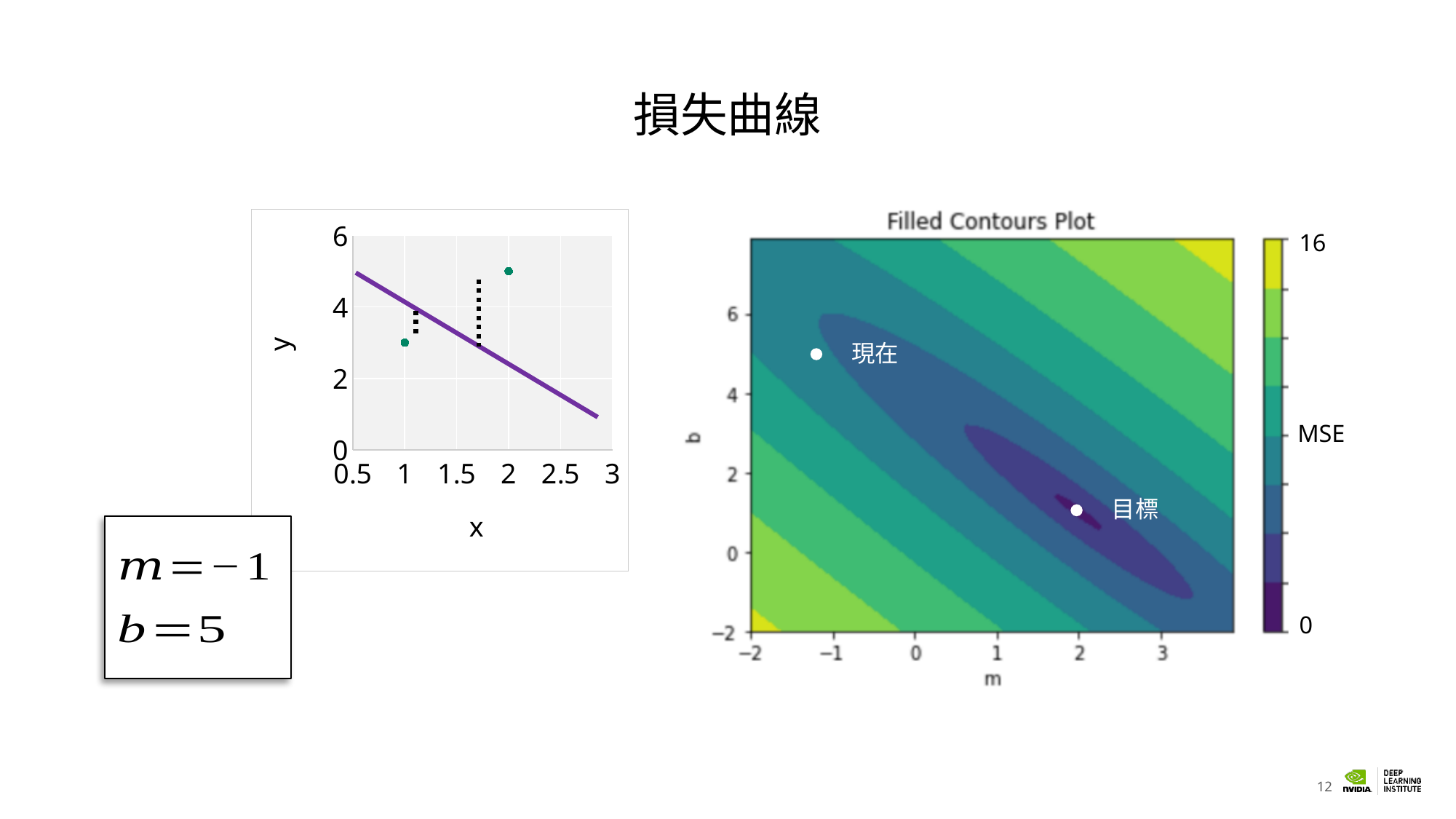
In the right chart, is the b value of the point labelled 現在 greater or less than 4? greater What is the title of the right chart? Filled Contours Plot In the right chart, what is the maximum value shown on the MSE colour bar? 16 In the left chart, which data point has the higher y value, the one at x = 1 or the one at x = 2? The one at x = 2 In the left chart, how many green data points are plotted? 2 In the right chart, is the m value of the point labelled 現在 greater or less than 0? less In the right chart, which labelled point has the larger b value, 現在 or 目標? 現在 In the right chart, is the b value of the point labelled 目標 greater or less than 2? less What kind of chart is the left chart on the slide? Scatter plot with a fitted line